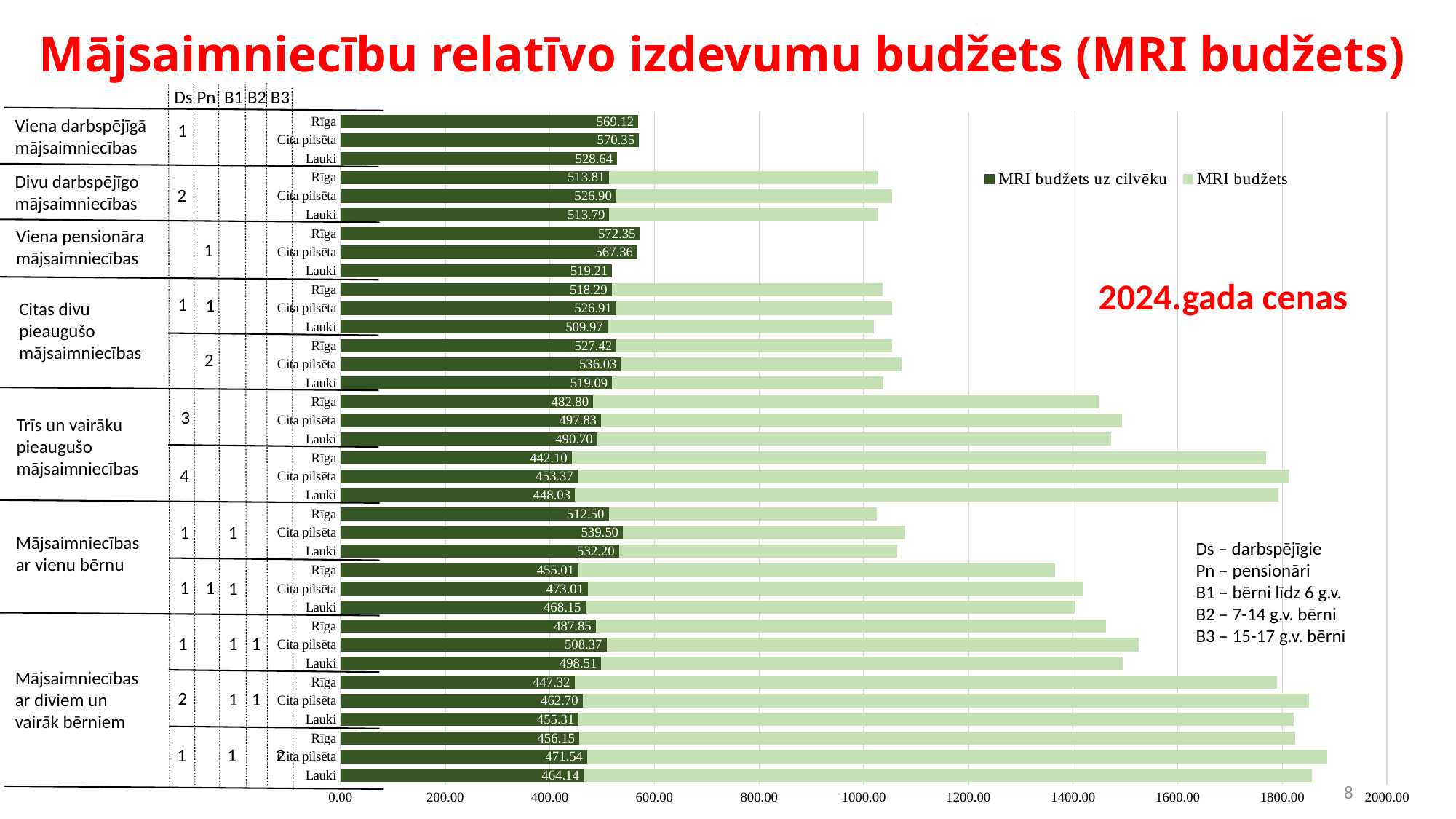
Which bar has the lowest MRI budžets uz cilvēku value on the chart? Rīga, Trīs un vairāku pieaugušo mājsaimniecības with Ds = 4 (442.10) In the 'Divu darbspējīgo mājsaimniecības' group, which has the larger MRI budžets uz cilvēku value, Rīga or Cita pilsēta? Cita pilsēta What is the MRI budžets uz cilvēku value for Lauki in the 'Divu darbspējīgo mājsaimniecības' group? 513.79 What is the MRI budžets uz cilvēku value for Cita pilsēta in the 'Viena pensionāra mājsaimniecības' group? 567.36 Which bar has the highest MRI budžets uz cilvēku value on the chart? Rīga, Viena pensionāra mājsaimniecības (572.35) In the 'Trīs un vairāku pieaugušo mājsaimniecības' group with Ds = 4, what is the MRI budžets uz cilvēku value for Cita pilsēta? 453.37 What are the two series named in the chart legend? MRI budžets uz cilvēku and MRI budžets What is the MRI budžets uz cilvēku value for Rīga in the 'Viena darbspējīgā mājsaimniecības' group? 569.12 What kind of chart is shown on the slide? Bar chart How many series does the legend list? 2 In the 'Viena darbspējīgā mājsaimniecības' group, what is the difference between the MRI budžets uz cilvēku values for Rīga and Lauki? 40.48